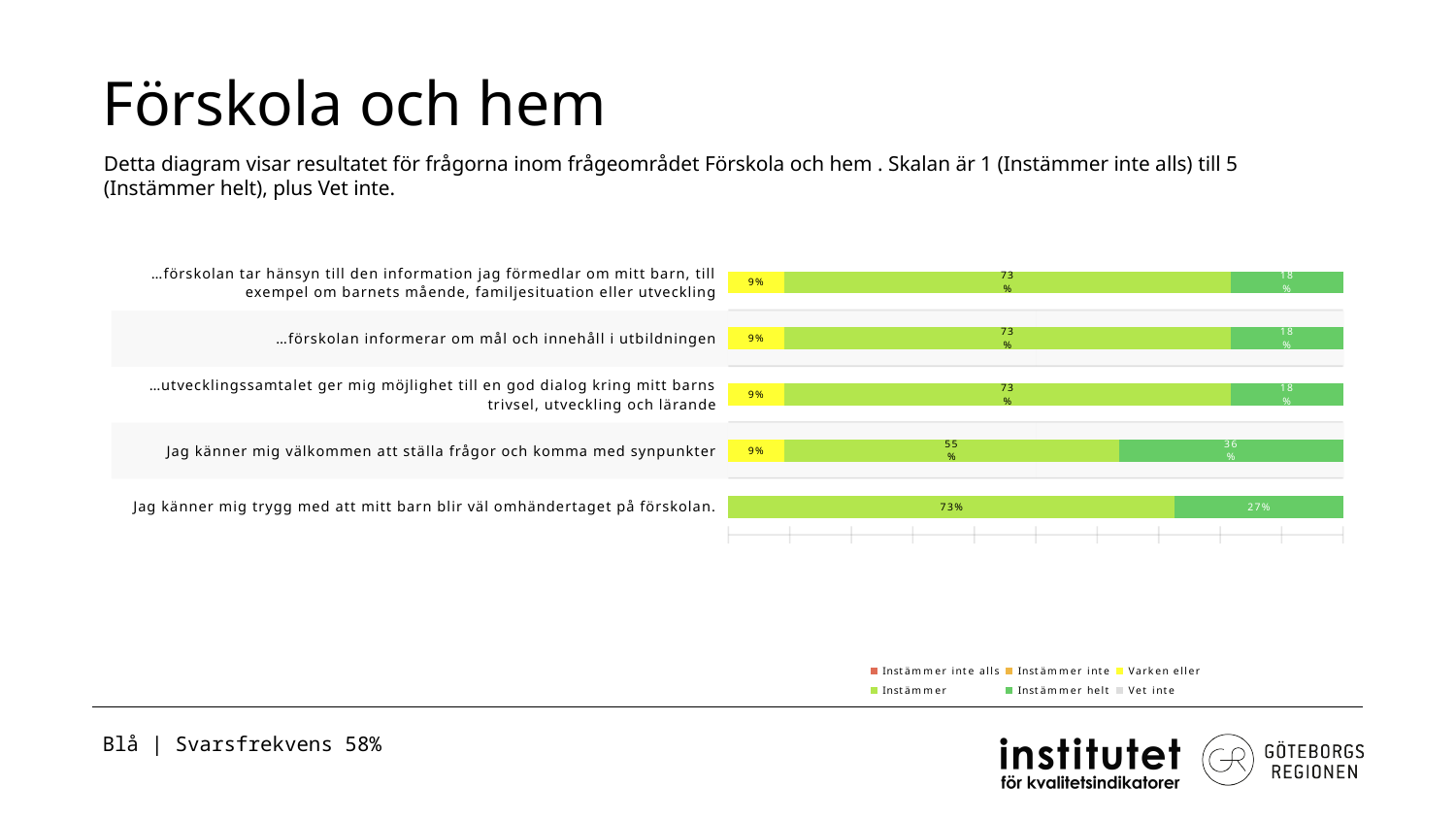
What is the 'Varken eller' value for '…förskolan informerar om mål och innehåll i utbildningen'? 9% What is the 'Instämmer helt' value for 'Jag känner mig välkommen att ställa frågor och komma med synpunkter'? 36% Which category has the lowest 'Instämmer' value? Jag känner mig välkommen att ställa frågor och komma med synpunkter How many categories (questions) are plotted in the chart? 5 What is the difference between the 'Instämmer helt' values for 'Jag känner mig välkommen att ställa frågor och komma med synpunkter' and '…förskolan informerar om mål och innehåll i utbildningen'? 18% What is the 'Instämmer helt' value for 'Jag känner mig trygg med att mitt barn blir väl omhändertaget på förskolan'? 27% Which is larger for 'Jag känner mig trygg med att mitt barn blir väl omhändertaget på förskolan': the 'Instämmer' value or the 'Instämmer helt' value? Instämmer What is the 'Instämmer' value for 'Jag känner mig välkommen att ställa frågor och komma med synpunkter'? 55% Which category has the highest 'Instämmer helt' value? Jag känner mig välkommen att ställa frågor och komma med synpunkter What is the 'Instämmer' value for '…förskolan tar hänsyn till den information jag förmedlar om mitt barn, till exempel om barnets mående, familjesituation eller utveckling'? 73% How many series does the legend list? 6 What kind of chart is shown on the slide? stacked bar chart